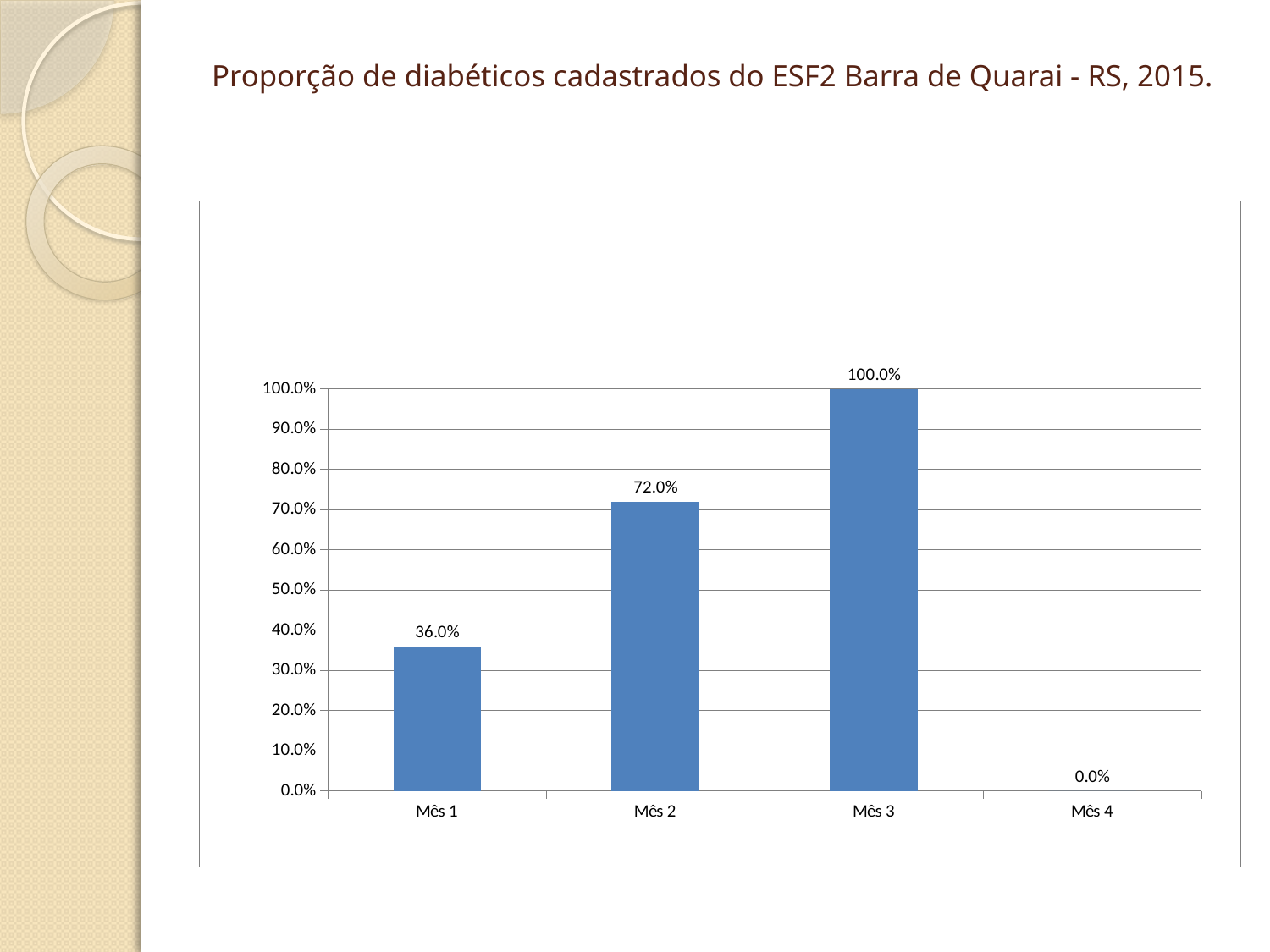
What is the difference between the values for Mês 3 and Mês 2? 28.0% Which is larger, the value for Mês 1 or the value for Mês 2? Mês 2 What is the title of the slide? Proporção de diabéticos cadastrados do ESF2 Barra de Quarai - RS, 2015. Which month has the highest value? Mês 3 What is the value for Mês 1? 36.0% How many months are shown on the x axis? 4 Which month has the lowest value? Mês 4 What is the value for Mês 2? 72.0% What is the difference between the values for Mês 2 and Mês 1? 36.0% What is the value for Mês 3? 100.0% What kind of chart is shown on the slide? Bar chart What is the value for Mês 4? 0.0%